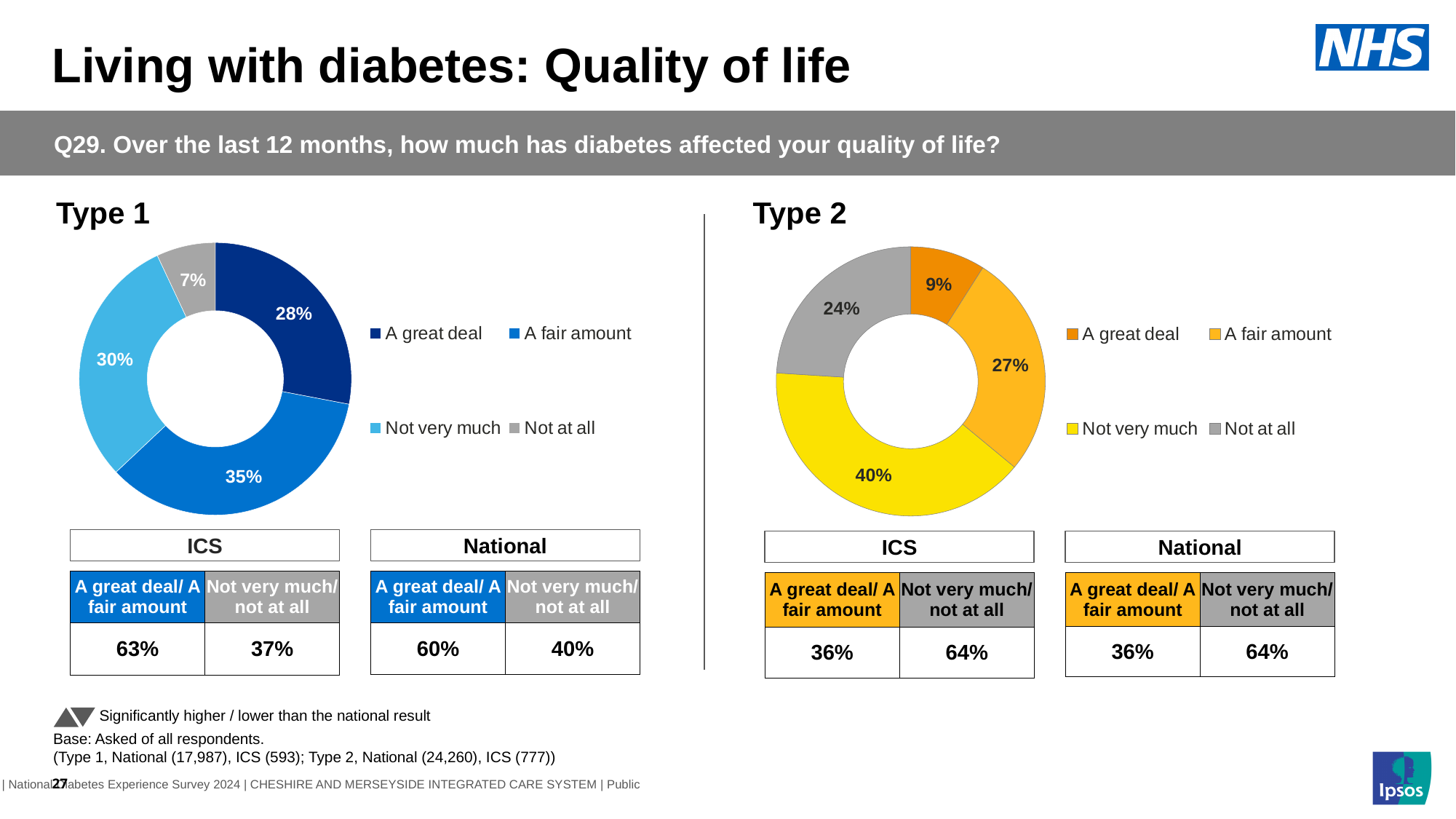
In the Type 1 chart, what colour represents 'Not at all'? Grey In the Type 1 chart, what is the difference between the 'Not very much' and 'Not at all' shares? 23 percentage points In the Type 2 chart, which is larger: 'A fair amount' or 'Not at all'? A fair amount How many categories does the Type 1 chart show? 4 In the Type 1 chart, which category has the largest share? A fair amount In the Type 2 chart, what percentage said 'Not at all'? 24% In the Type 1 chart, what is the combined share of 'A great deal' and 'A fair amount'? 63% In the Type 2 chart, what is the combined share of 'Not very much' and 'Not at all'? 64% What type of chart is used for Type 2? Doughnut chart In the Type 2 chart, which category has the smallest share? A great deal In the Type 1 chart, what percentage of respondents said diabetes affected their quality of life 'A great deal'? 28% In the Type 2 chart, what percentage of respondents said 'Not very much'? 40%